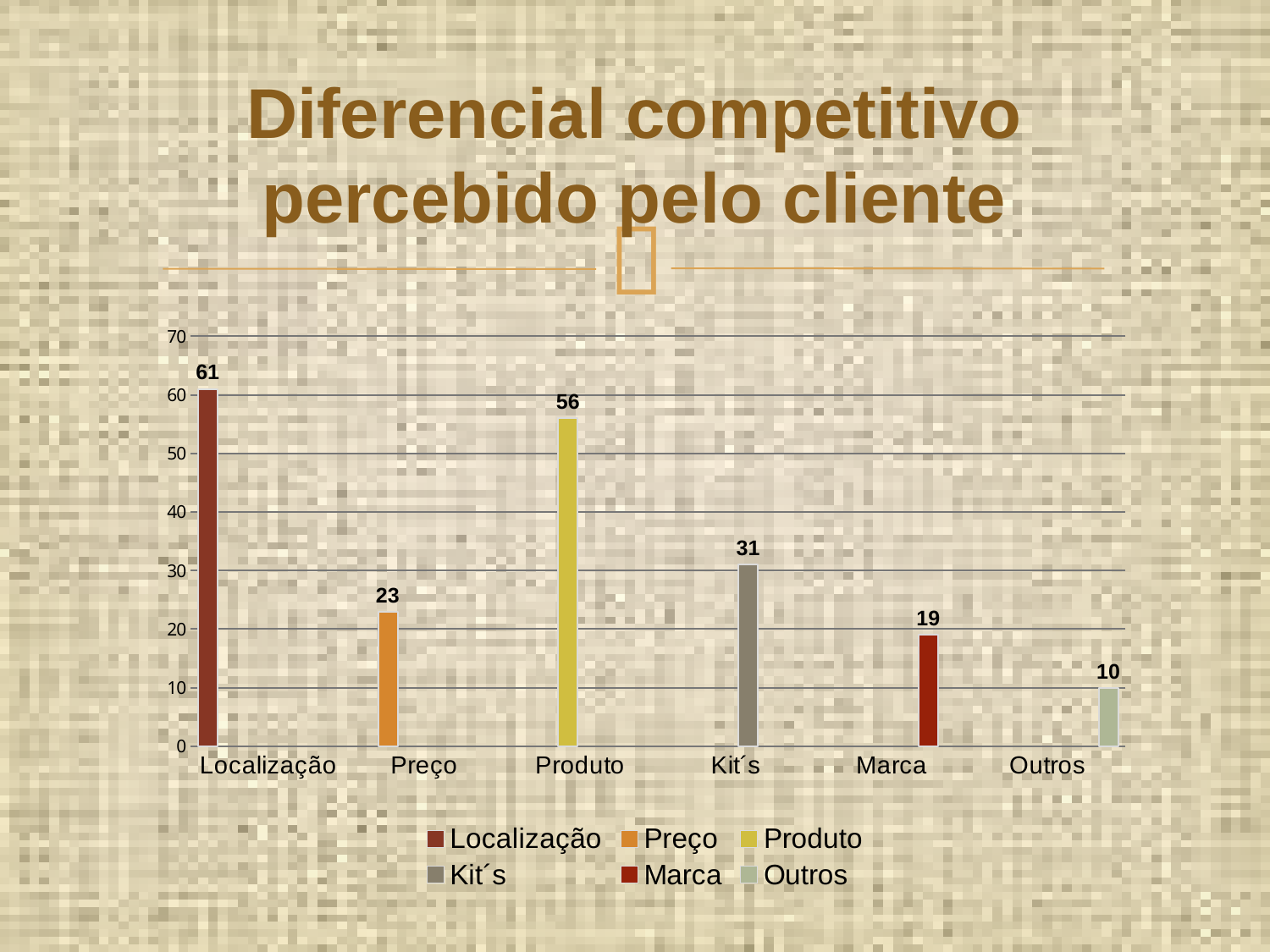
What is the value for Kit´s? 31 How many categories are shown on the x axis? 6 How many entries does the legend list? 6 What is the value for Produto? 56 Which category has the lowest value? Outros What kind of chart is shown on the slide? Bar chart Which category has the highest value? Localização What is the difference between the values for Localização and Produto? 5 What is the value for Outros? 10 What is the difference between the values for Kit´s and Marca? 12 What is the value for Localização? 61 Which is larger, the value for Preço or the value for Marca? Preço